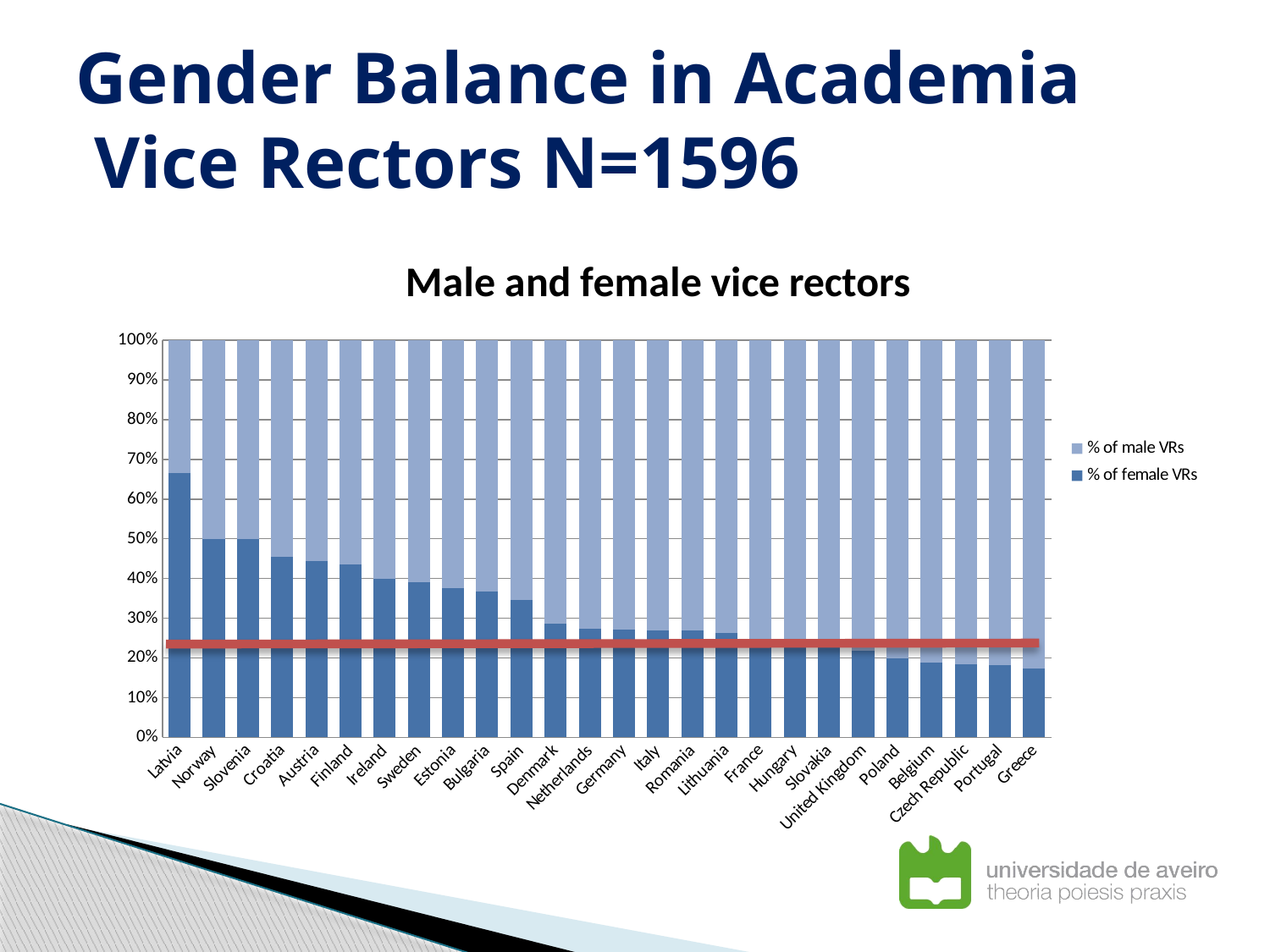
Which has a higher % of female VRs, Croatia or Poland? Croatia Is the % of female VRs for Greece greater or less than 20%? less How many countries are shown on the x axis of the chart? 26 How many series does the legend list? 2 Which country has the highest % of female VRs? Latvia What is the title of the chart? Male and female vice rectors What do the two stacked segments for Germany add up to? 100% Is the % of female VRs for Denmark greater or less than 30%? less What kind of chart is shown on the slide? stacked bar chart Is the % of female VRs for Latvia greater or less than 60%? greater Does the % of female VRs rise or fall moving from left to right along the x axis? fall